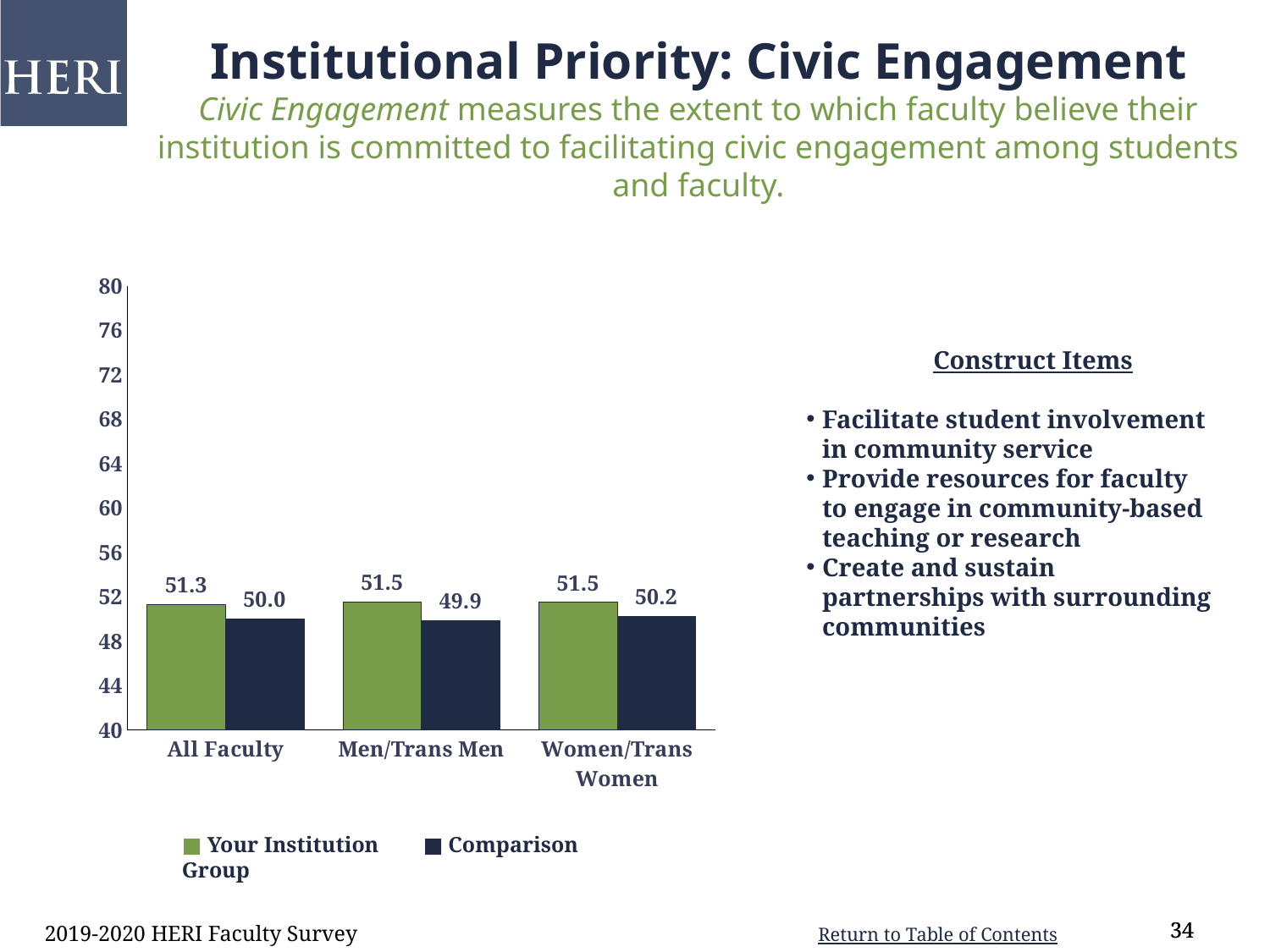
Which category has the lowest Your Institution value? All Faculty What is the difference between the Your Institution and Comparison Group values for Men/Trans Men? 1.6 Which category has the highest Comparison Group value? Women/Trans Women What is the Comparison Group value for Men/Trans Men? 49.9 What is the Your Institution value for All Faculty? 51.3 How many categories are shown on the x axis? 3 What is the Comparison Group value for Women/Trans Women? 50.2 Which category has the lowest Comparison Group value? Men/Trans Men Is the Comparison Group value for All Faculty greater or less than 56? less What kind of chart is shown on the slide? Bar chart What is the Your Institution value for Women/Trans Women? 51.5 For All Faculty, which is larger: the Your Institution value or the Comparison Group value? Your Institution